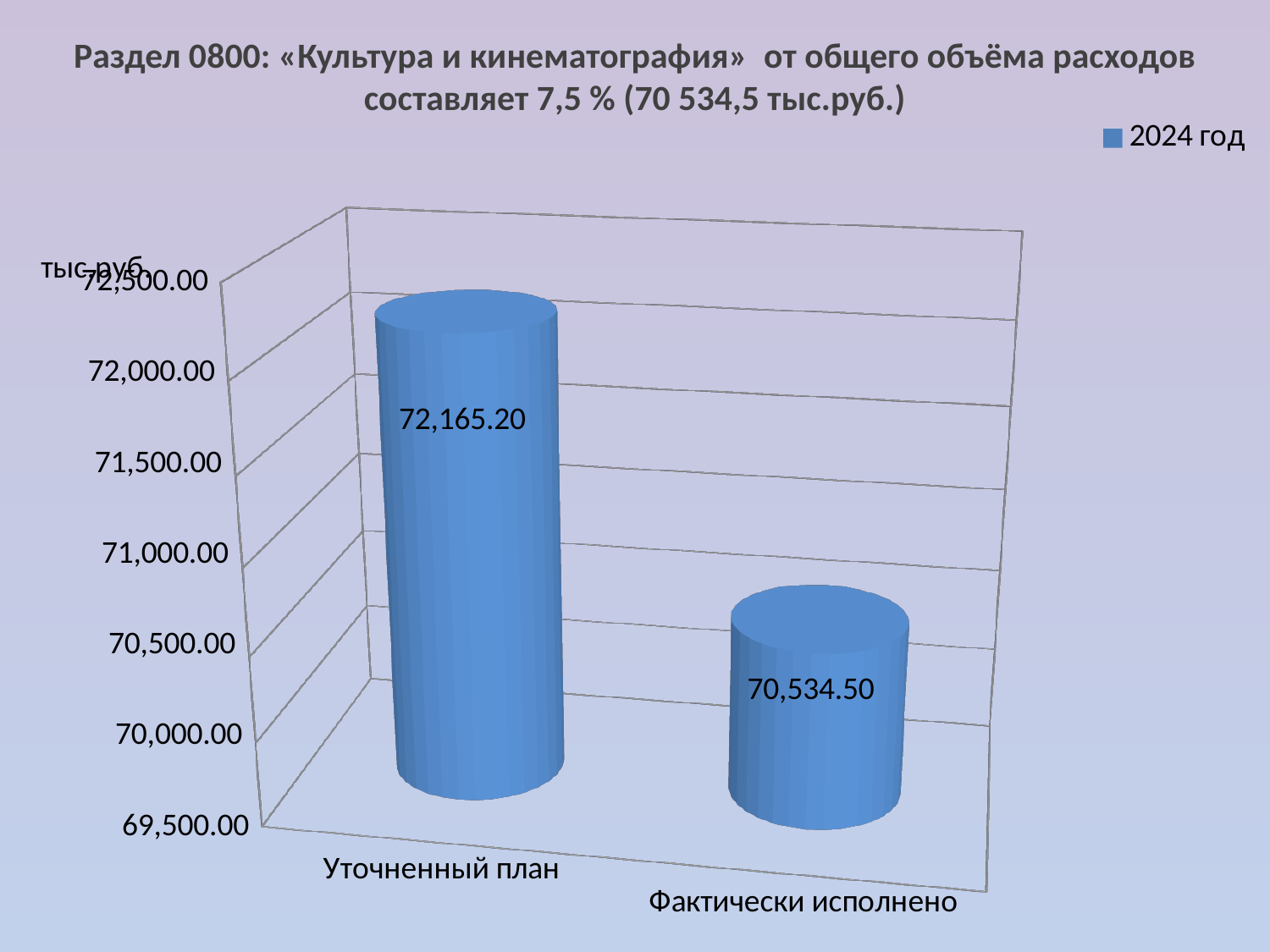
Which category has the lowest value? Фактически исполнено Is the value for «Фактически исполнено» greater or less than 71,000.00? less What kind of chart is shown on the slide? bar chart Is the value for «Уточненный план» greater or less than 72,000.00? greater What series name is shown in the chart legend? 2024 год Which is larger: «Уточненный план» or «Фактически исполнено»? Уточненный план Which category has the highest value? Уточненный план What is the value for «Уточненный план»? 72,165.20 How many categories are shown on the chart? 2 What is the value for «Фактически исполнено»? 70,534.50 How many series does the legend list? 1 What is the difference between «Уточненный план» and «Фактически исполнено»? 1,630.70